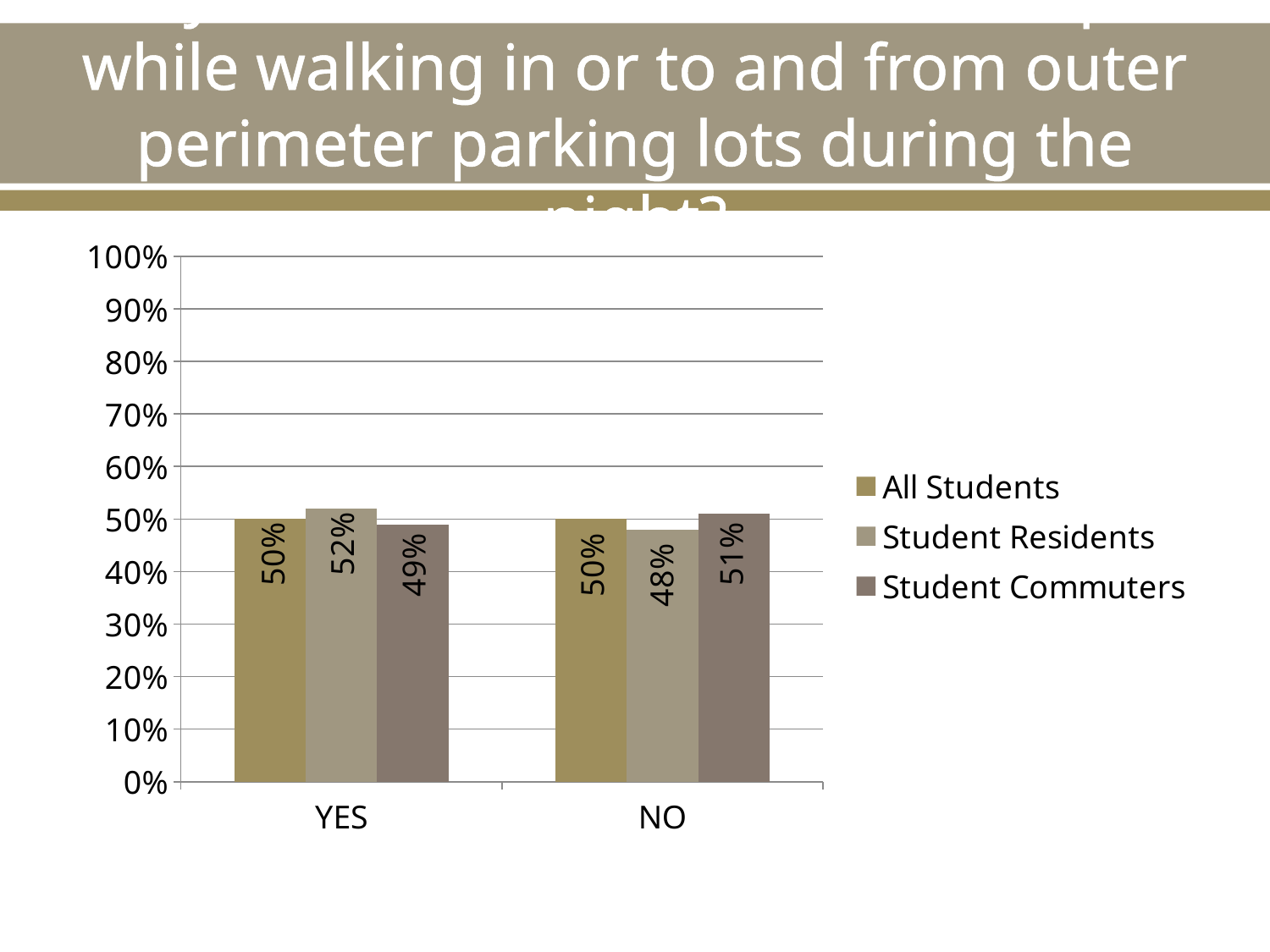
Which series has the lowest value in the NO category? Student Residents What is the value for Student Residents in the YES category? 52% Which is larger: Student Commuters for YES or Student Commuters for NO? Student Commuters for NO What is the difference between the Student Residents value for YES and for NO? 4% What are the three series listed in the legend? All Students, Student Residents, Student Commuters What is the value for All Students in the YES category? 50% Which series has the highest value in the YES category? Student Residents What kind of chart is shown on the slide? Bar chart How many series does the legend list? 3 How many categories are shown on the x axis? 2 What is the value for Student Residents in the NO category? 48% What is the value for Student Commuters in the NO category? 51%